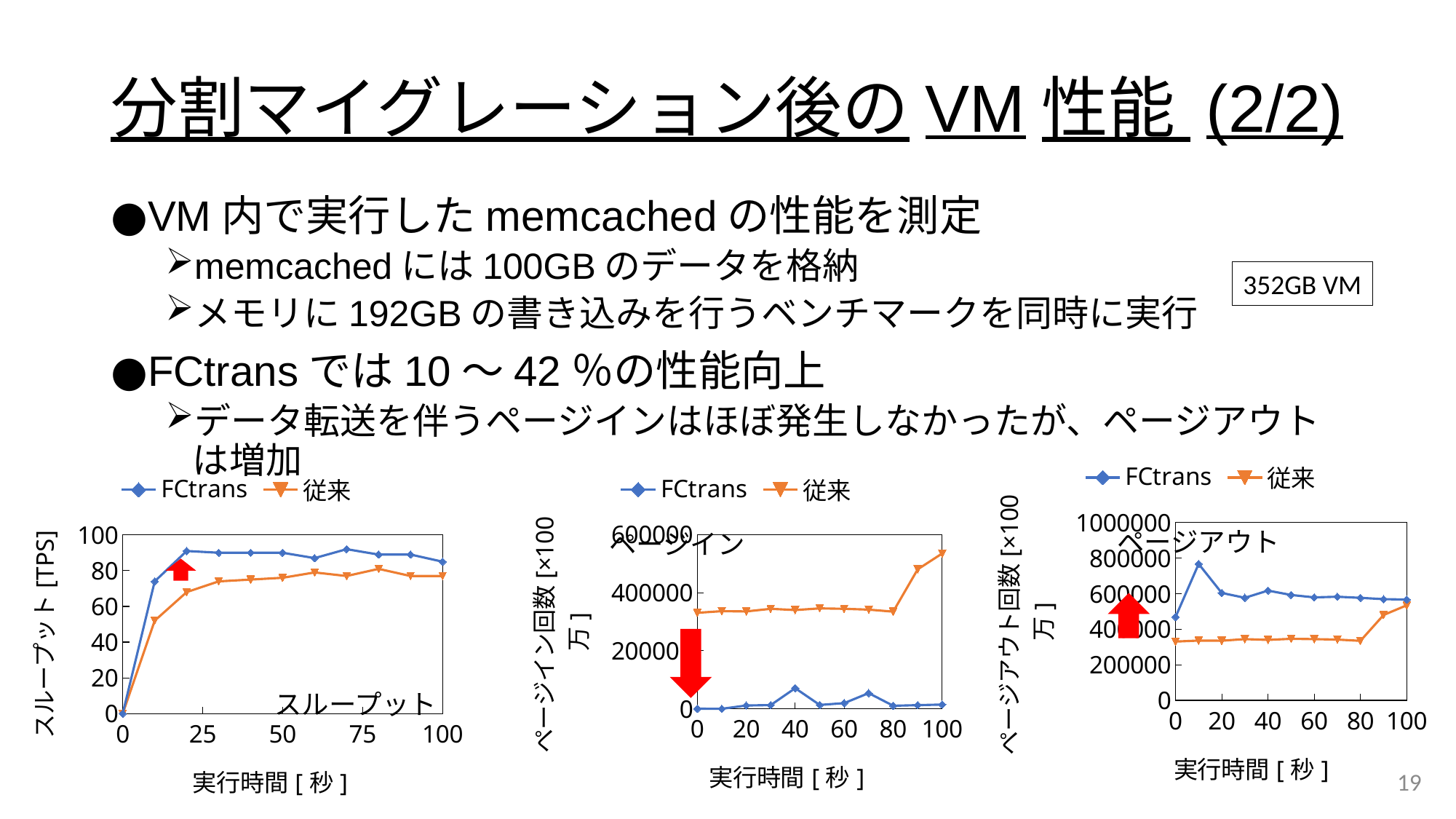
What is the y-axis label of the スループット chart? スループット [TPS] In the ページアウト chart, is the FCtrans value at 10 seconds greater or less than 600000? greater In the ページイン chart, does the 従来 series rise or fall between 80 and 100 seconds? rise In the ページアウト chart, at which time on the x axis does the FCtrans series reach its highest value? 10 How many series does the legend of the ページイン chart list? 2 In the スループット chart, is the 従来 value at 10 seconds greater or less than 60? less In the ページイン chart, is the 従来 value at 100 seconds greater or less than 400000? greater What kind of chart is the スループット chart on the left? line chart In the スループット chart, which series has the higher value at 50 seconds, FCtrans or 従来? FCtrans What are the two legend entries on the ページアウト chart? FCtrans and 従来 In the ページイン chart, which series has the higher value at 40 seconds, FCtrans or 従来? 従来